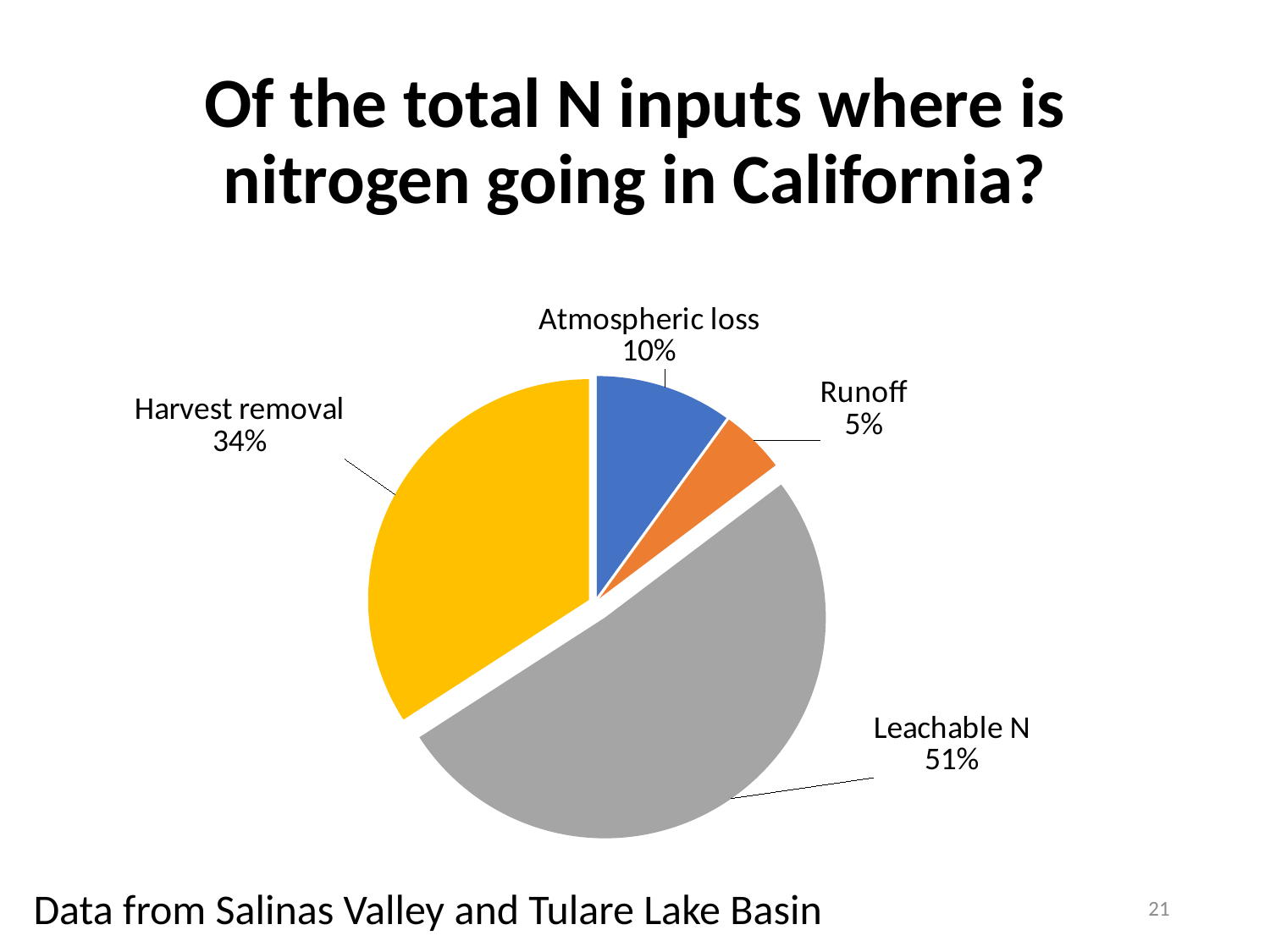
What kind of chart is shown on the slide? pie chart What is the difference in percentage points between Leachable N and Harvest removal? 17 What is the difference in percentage points between Atmospheric loss and Runoff? 5 What share of total N inputs goes to Harvest removal? 34% What share of total N inputs goes to Runoff? 5% How many categories are shown in the pie chart? 4 What share of total N inputs goes to Atmospheric loss? 10% Which category has the largest slice of the pie? Leachable N Which is larger, Atmospheric loss or Runoff? Atmospheric loss Which category has the smallest slice of the pie? Runoff What colour is the Leachable N slice? grey